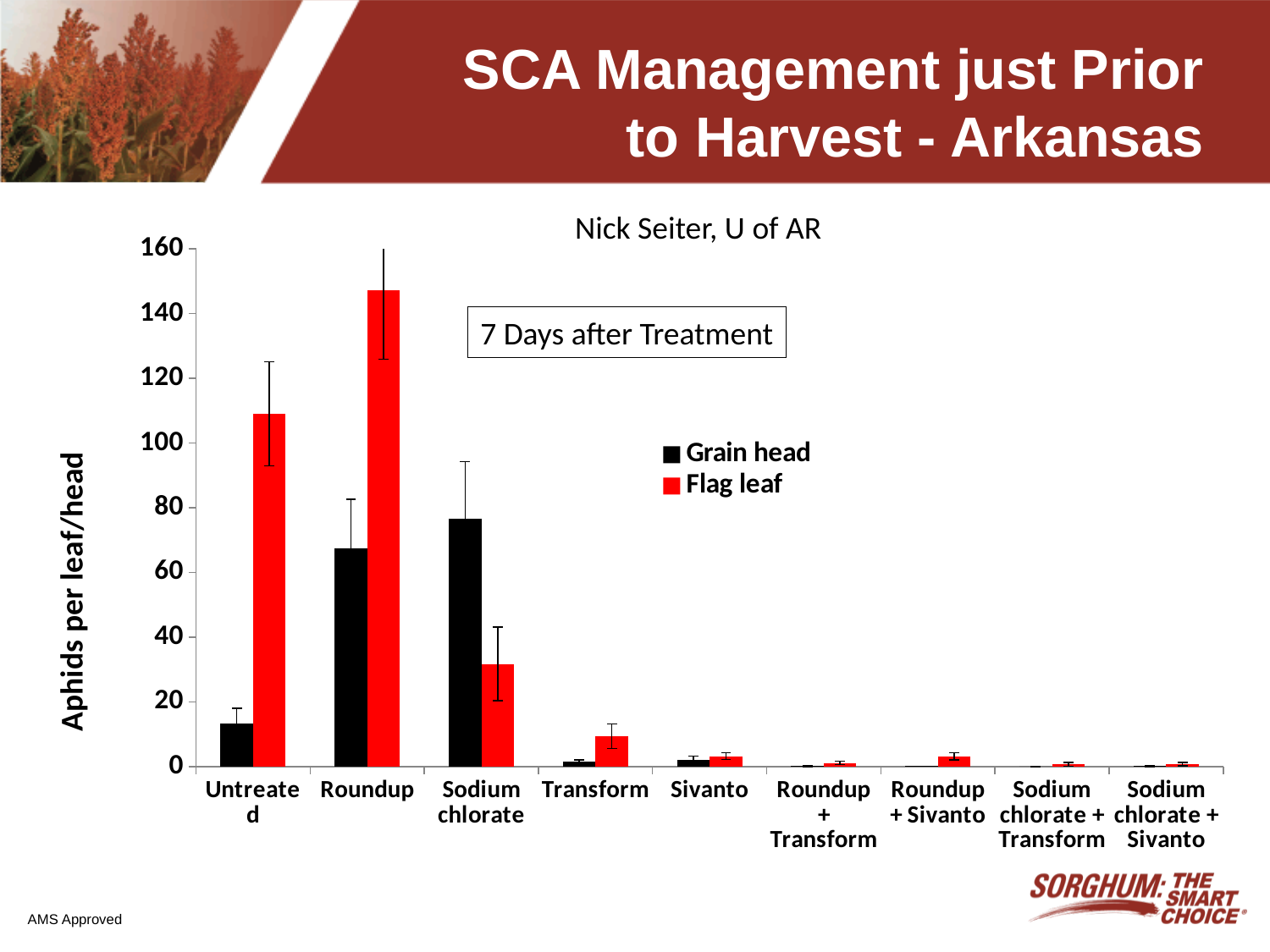
Is the Flag leaf value for Untreated greater or less than 100? greater What kind of chart is shown on the slide? bar chart Is the Flag leaf value for Sodium chlorate greater or less than 40? less For Sodium chlorate, which series has the larger value, Grain head or Flag leaf? Grain head What is the label on the y axis of the chart? Aphids per leaf/head For the Untreated category, which series has the larger value, Grain head or Flag leaf? Flag leaf How many treatment categories are shown on the x axis? 9 Which treatment has the highest Grain head value? Sodium chlorate Which treatment has the highest Flag leaf value? Roundup Is the Flag leaf value for Roundup greater or less than 140? greater How many series does the legend list? 2